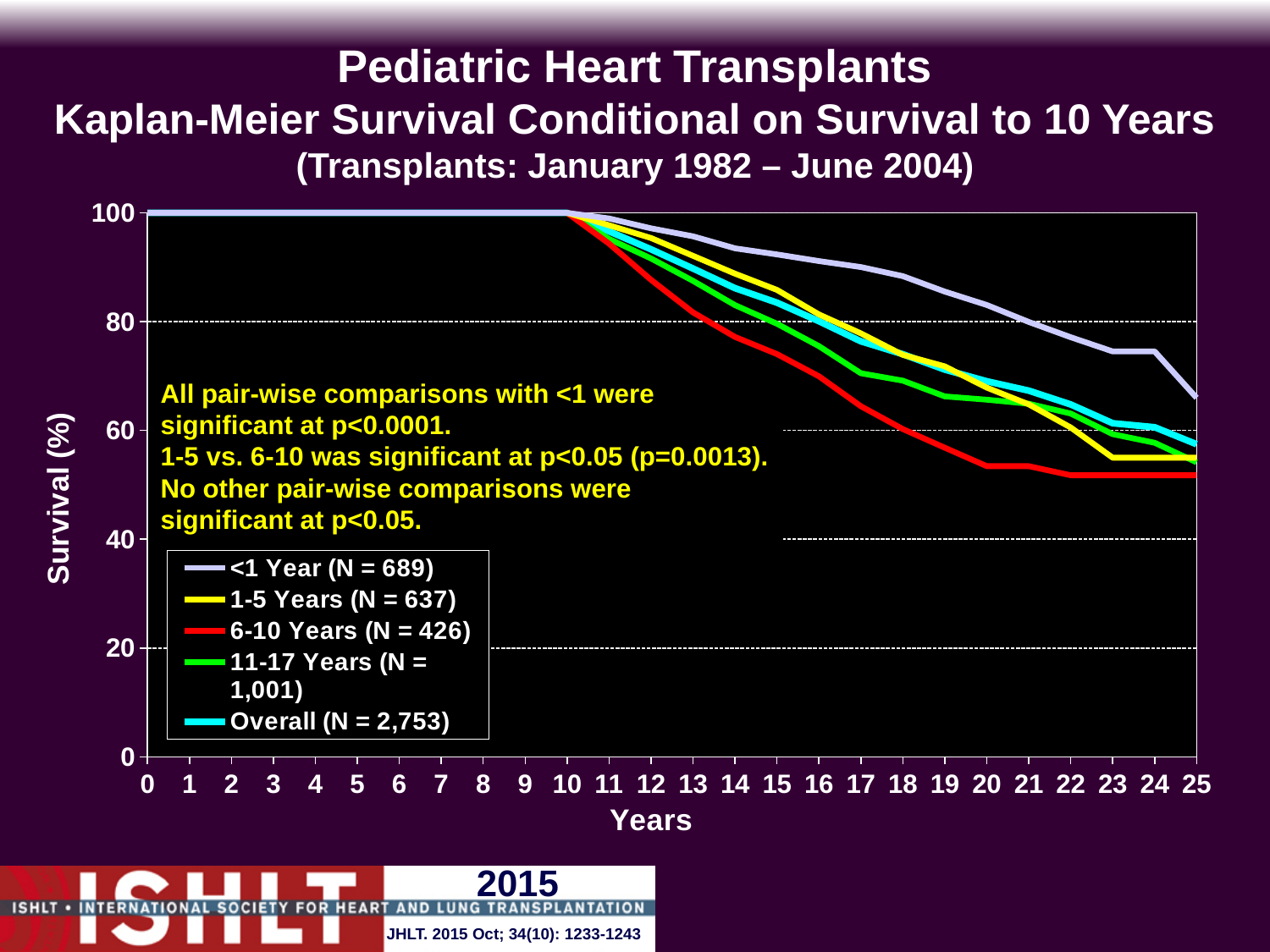
How many series does the legend list? 5 Which series has the highest survival at 25 years? <1 Year Do the survival curves rise or fall after year 10? fall What is the survival (%) for the Overall series at 5 years? 100 Is the survival for the 6-10 Years series at 15 years greater or less than 80? less What colour is the line for the 6-10 Years series? red Is the survival for the 6-10 Years series at 25 years greater or less than 60? less Which series has the lowest survival at 25 years? 6-10 Years What kind of chart is shown on the slide? line chart At 20 years, which series has higher survival: <1 Year or 6-10 Years? <1 Year What is the N for the 11-17 Years series in the legend? 1,001 Is the survival for the <1 Year series at 15 years greater or less than 80? greater